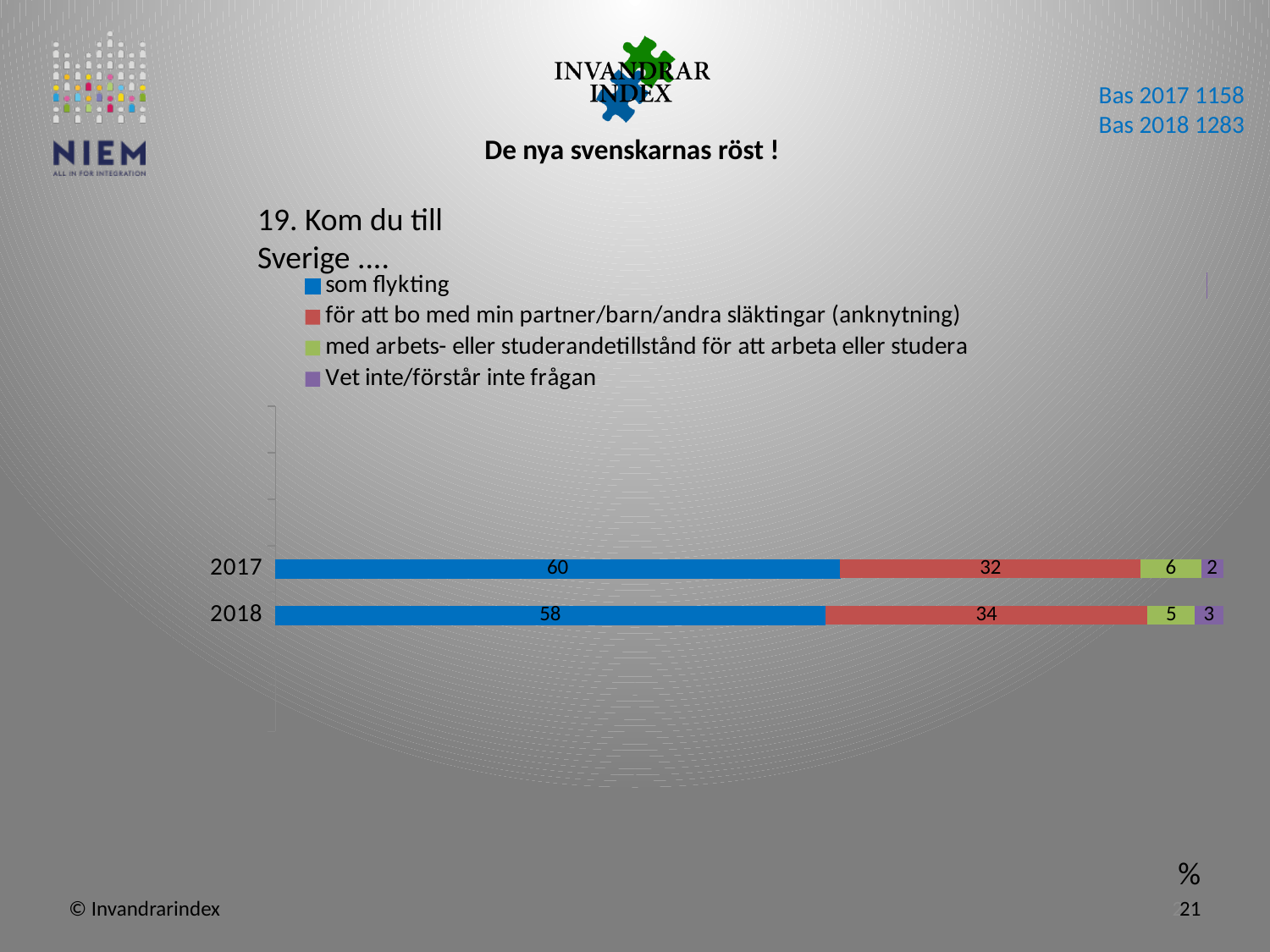
What is the difference between the "som flykting" values for 2017 and 2018? 2 Which series has the highest value in 2018? som flykting Which series has the lowest value in 2017? Vet inte/förstår inte frågan How many series does the legend list? 4 What is the total of the stacked bar for 2017? 100 What is the value for "som flykting" in 2018? 58 What kind of chart is shown on the slide? Stacked bar chart What is the value for "för att bo med min partner/barn/andra släktingar (anknytning)" in 2018? 34 What is the value for "Vet inte/förstår inte frågan" in 2018? 3 What is the value for "som flykting" in 2017? 60 What is the value for "med arbets- eller studerandetillstånd för att arbeta eller studera" in 2017? 6 Which year has the larger value for "för att bo med min partner/barn/andra släktingar (anknytning)", 2017 or 2018? 2018